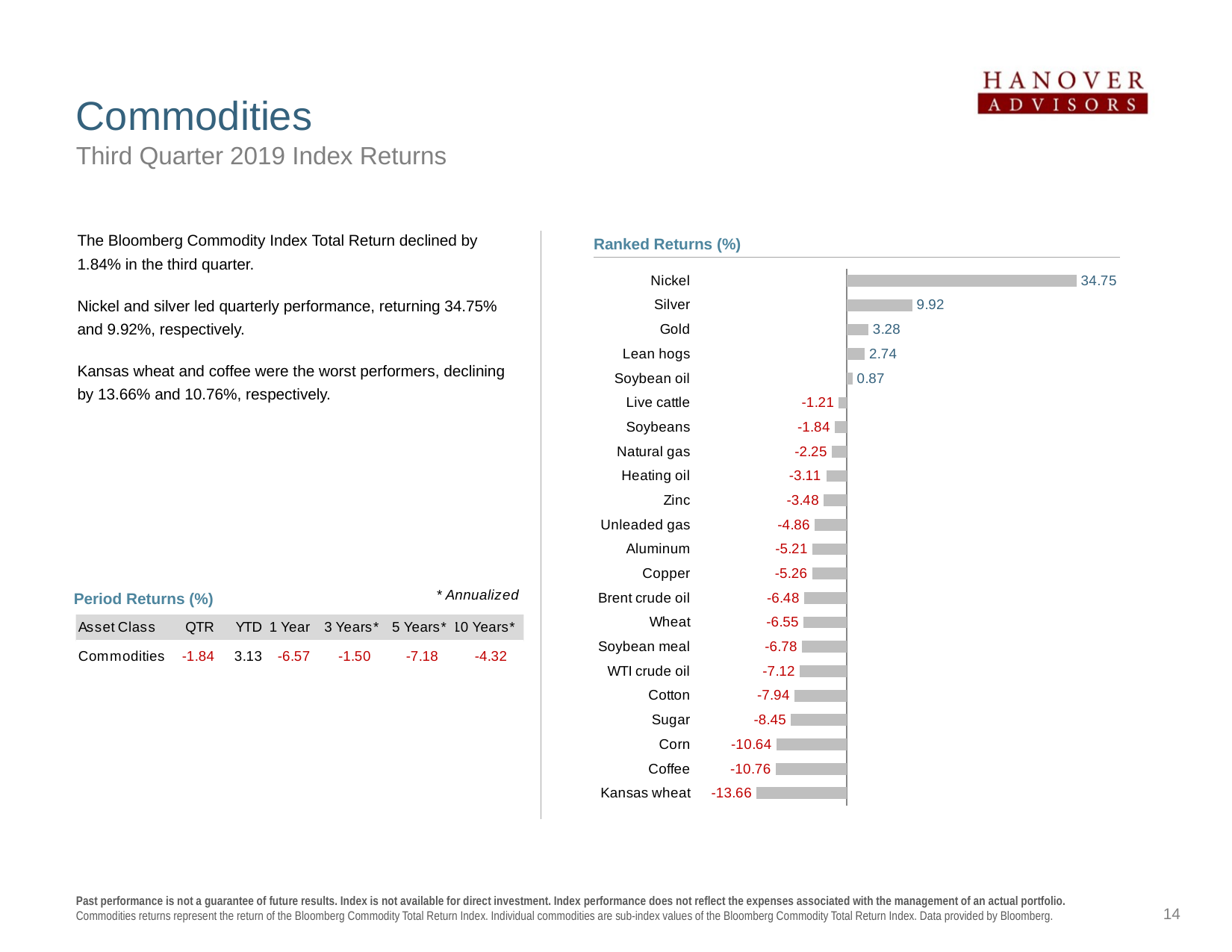
In the Ranked Returns (%) chart, which has the larger value, Sugar or Corn? Sugar What kind of chart is the Ranked Returns (%) chart? Bar chart What is the value for Copper in the Ranked Returns (%) chart? -5.26 Which commodity has the highest value in the Ranked Returns (%) chart? Nickel What is the difference between the values for Nickel and Silver in the Ranked Returns (%) chart? 24.83 How many commodities in the Ranked Returns (%) chart have a positive value? 5 What is the value for Soybean oil in the Ranked Returns (%) chart? 0.87 How many commodities are shown in the Ranked Returns (%) chart? 22 Which commodity has the lowest value in the Ranked Returns (%) chart? Kansas wheat What is the value for Nickel in the Ranked Returns (%) chart? 34.75 In the Ranked Returns (%) chart, which has the larger value, Gold or Lean hogs? Gold What is the difference between the values for Coffee and Kansas wheat in the Ranked Returns (%) chart? 2.90